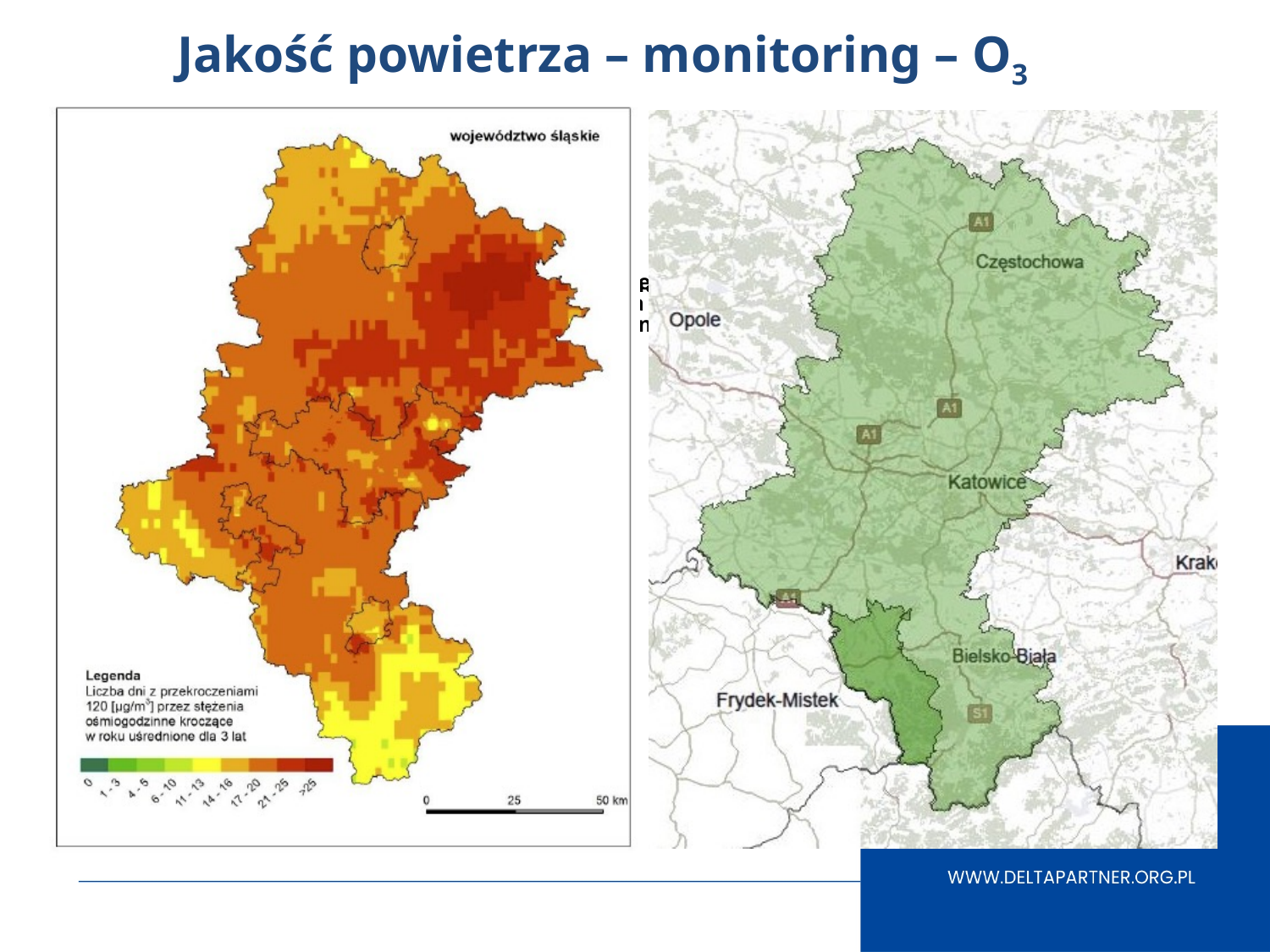
On the left map, what is the maximum distance shown on the scale bar? 50 km On the left map, how many colour classes does the legend list? 9 On the left map, what is the lowest legend class? 0 What kind of visualisation is shown on the left side of the slide? a map (choropleth map of województwo śląskie) On the left map, what is the highest legend class? >25 On the left map, what concentration threshold does the legend refer to? 120 [µg/m³] On the left map, which region is named in the top-right corner? województwo śląskie